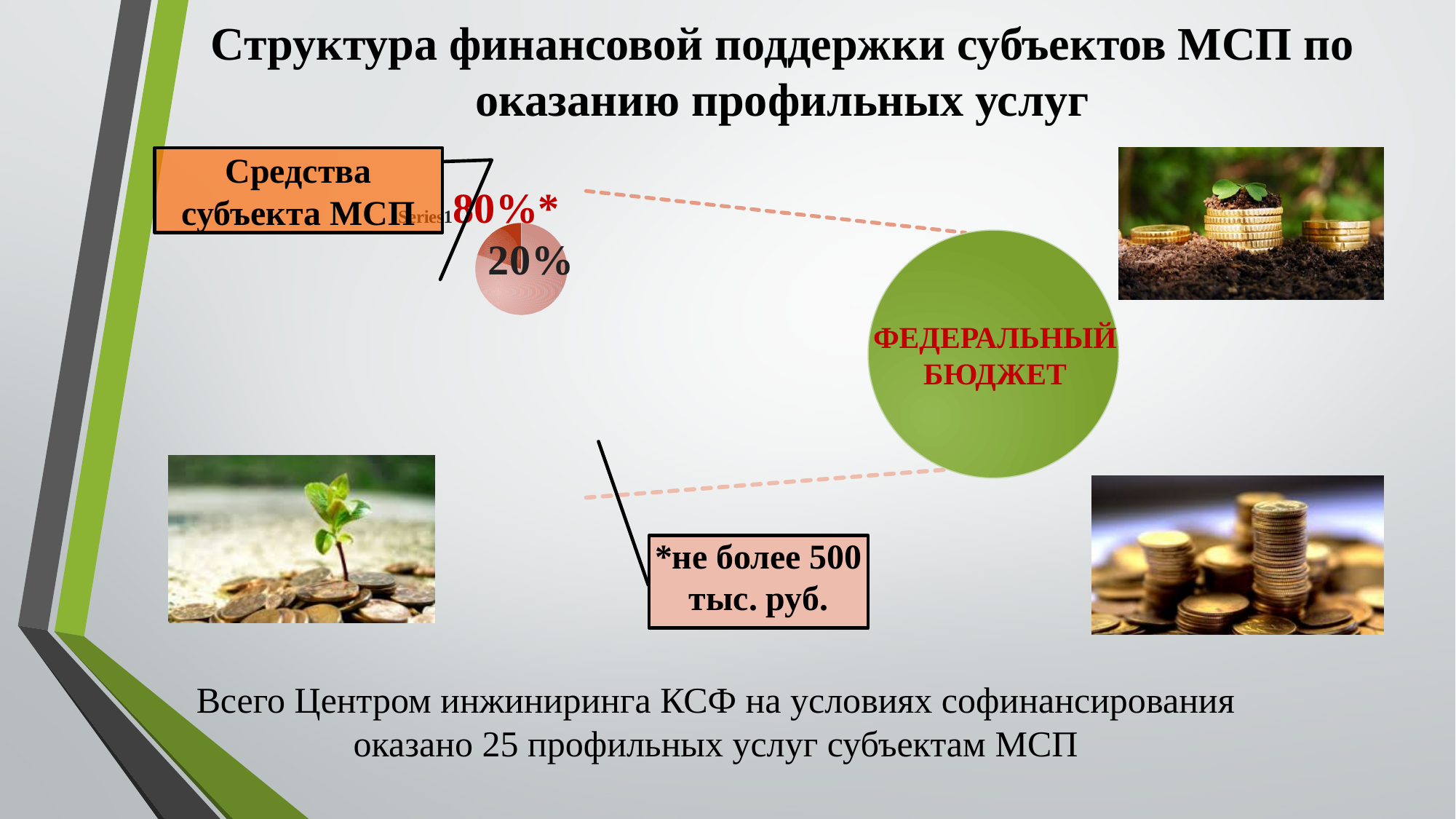
How many slices does the pie chart have? 2 Which slice of the pie chart is larger, the one labelled 80% or the one labelled 20%? 80% Which slice label on the pie chart carries an asterisk? 80%* What is the difference between the two slices of the pie chart? 60% What is the value of the smallest slice of the pie chart? 20% What does the asterisk note on the slide say about the 80% share? *не более 500 тыс. руб. What do the two slices of the pie chart add up to? 100% What is the value of the largest slice of the pie chart? 80% What kind of chart is shown on the slide? pie chart Is the value of the smaller slice of the pie chart greater or less than 50%? less Is the value of the larger slice of the pie chart greater or less than 50%? greater